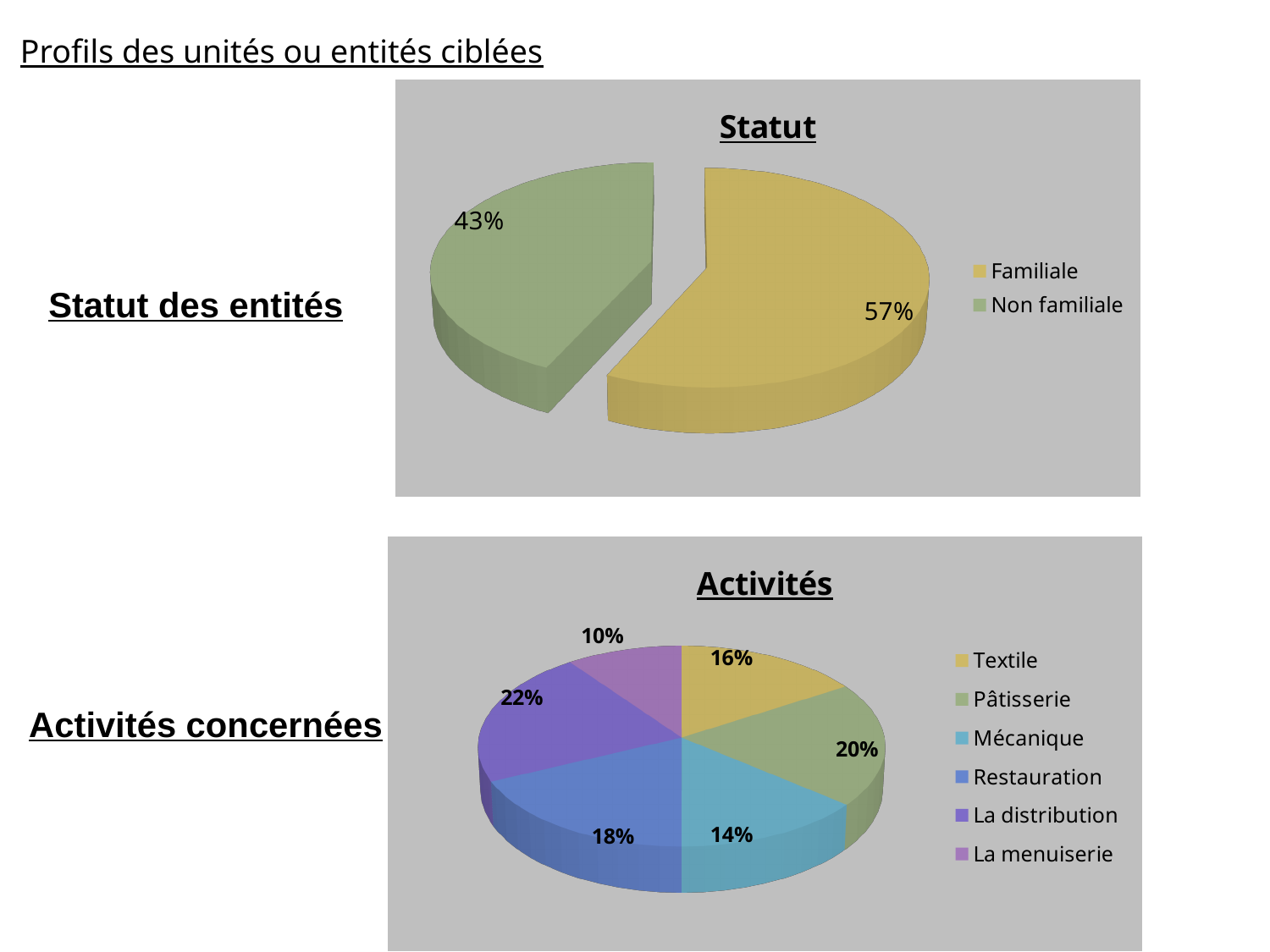
In the 'Activités' chart, which activity has the largest share? La distribution How many categories does the legend of the 'Activités' chart list? 6 In the 'Statut' chart, what is the difference between the Familiale and Non familiale shares? 14% In the 'Activités' chart, what share is Mécanique? 14% In the 'Statut' chart, what share is Familiale? 57% In the 'Activités' chart, which is larger: Pâtisserie or Restauration? Pâtisserie In the 'Activités' chart, what share is La distribution? 22% What kind of chart is the 'Statut' chart? Pie chart In the 'Activités' chart, which activity has the smallest share? La menuiserie In the 'Statut' chart, what share is Non familiale? 43% In the 'Statut' chart, which category has the larger share? Familiale In the 'Activités' chart, what is the difference between the Textile and La menuiserie shares? 6%